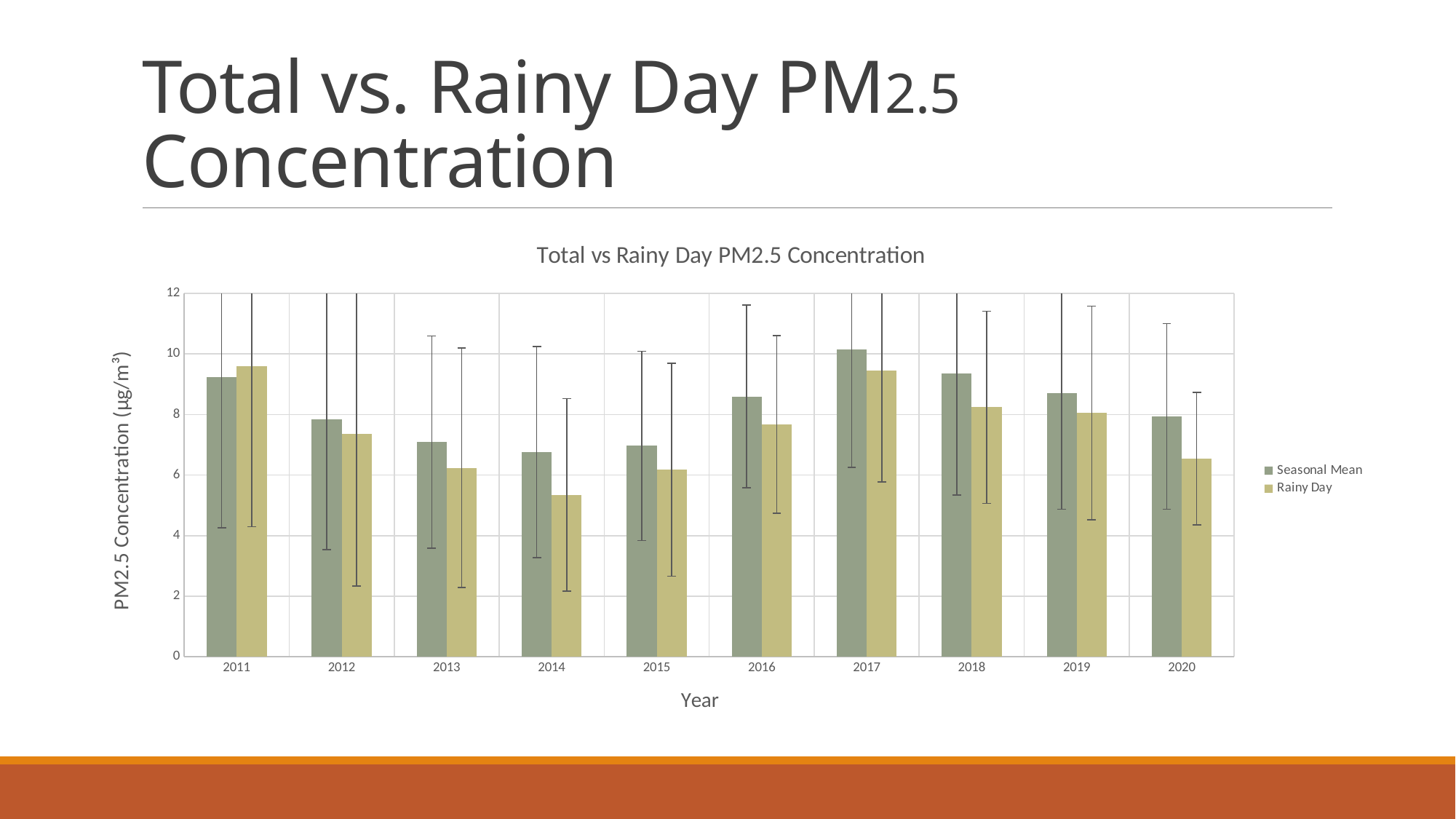
Is the Seasonal Mean value for 2011 greater or less than 8? greater In 2014, which is larger: the Seasonal Mean or the Rainy Day value? Seasonal Mean What is the label of the y axis? PM2.5 Concentration (µg/m³) What is the title of the chart? Total vs Rainy Day PM2.5 Concentration Which year has the highest Seasonal Mean value? 2017 Is the Rainy Day value for 2014 greater or less than 6? less Is the Rainy Day value for 2013 greater or less than 8? less What kind of chart is shown on the slide? bar chart Which year has the lowest Rainy Day value? 2014 Which is larger: the Seasonal Mean for 2017 or the Seasonal Mean for 2020? 2017 How many years are shown on the x axis? 10 How many series does the legend list? 2